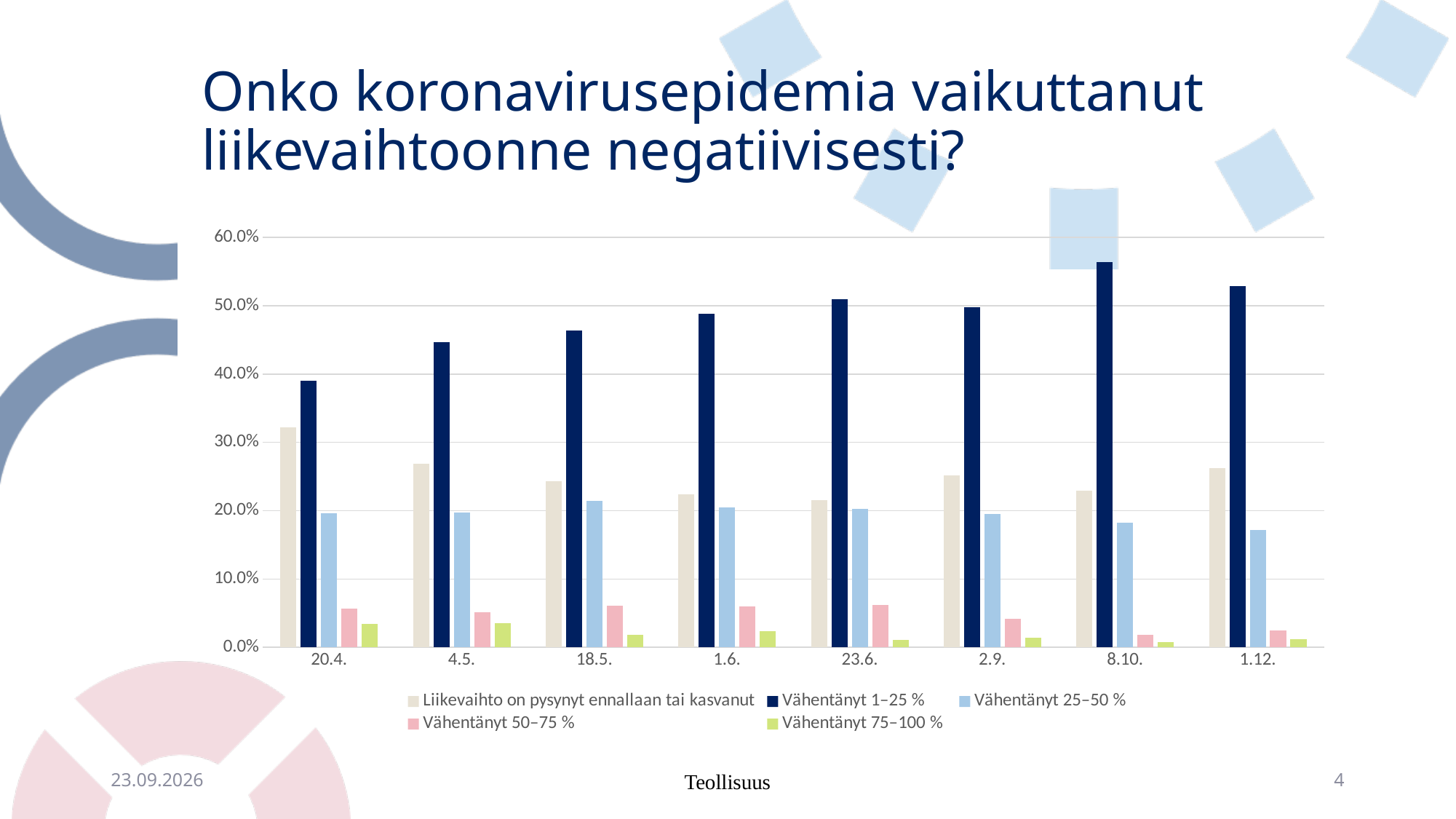
How many dates (categories) are shown on the x axis? 8 How many series does the legend list? 5 Does the value for 'Vähentänyt 1–25 %' rise or fall from 20.4. to 23.6.? rise Is the value for 'Vähentänyt 1–25 %' at 8.10. greater or less than 50.0%? greater At which date is the value for 'Vähentänyt 1–25 %' highest? 8.10. At which date is the value for 'Vähentänyt 25–50 %' lowest? 1.12. At which date is the value for 'Vähentänyt 1–25 %' lowest? 20.4. Is the value for 'Liikevaihto on pysynyt ennallaan tai kasvanut' at 20.4. greater or less than 30.0%? greater Is the value for 'Vähentänyt 1–25 %' at 20.4. greater or less than 40.0%? less At which date is the value for 'Liikevaihto on pysynyt ennallaan tai kasvanut' highest? 20.4. What kind of chart is shown on the slide? bar chart At 1.12., which is larger: 'Liikevaihto on pysynyt ennallaan tai kasvanut' or 'Vähentänyt 25–50 %'? Liikevaihto on pysynyt ennallaan tai kasvanut